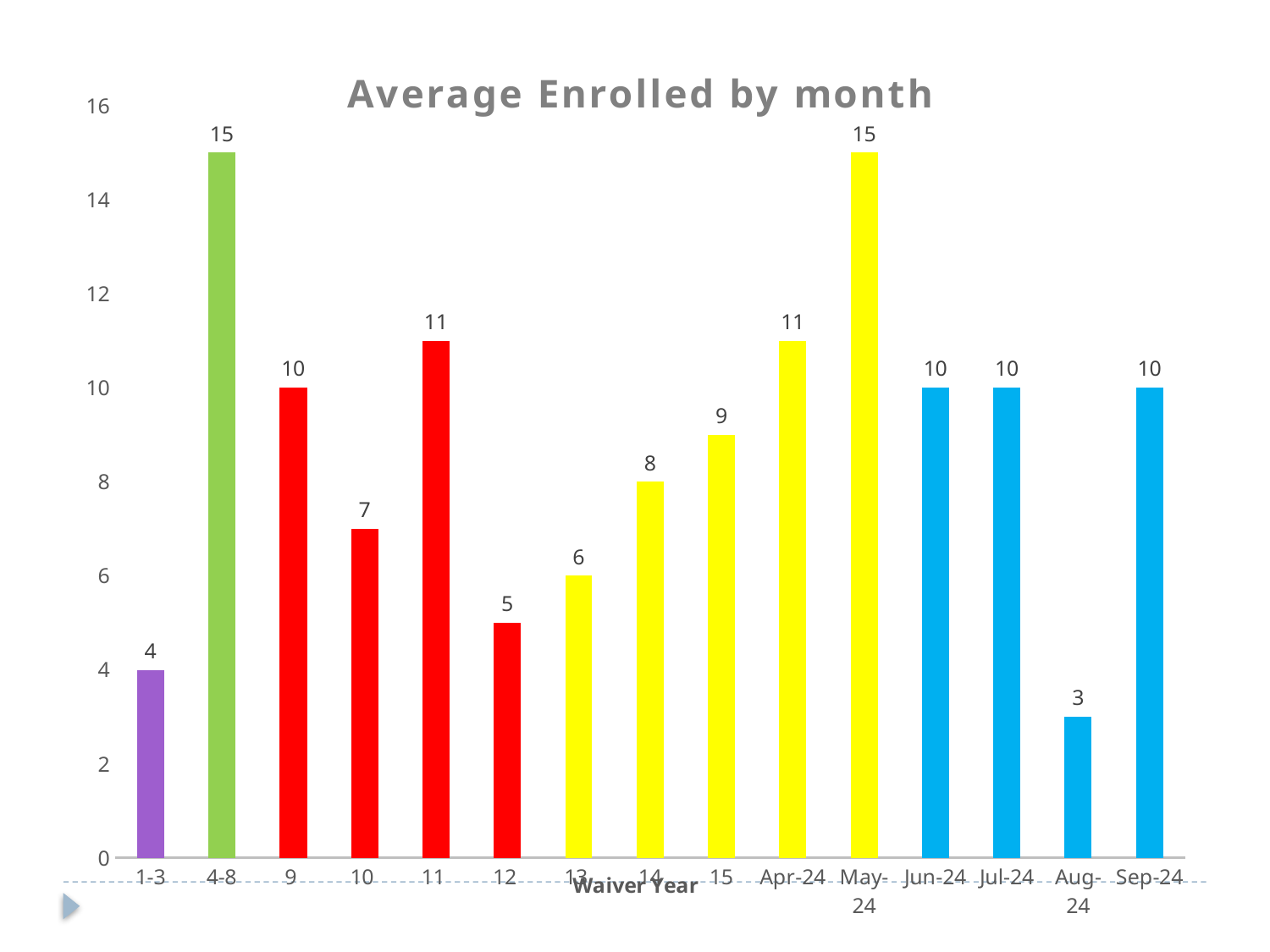
Which category has the lowest value? Aug-24 What is the value for 12? 5 Which is larger, the value for 14 or the value for 13? 14 What is the value for Apr-24? 11 How many categories are shown on the x axis? 15 What is the value for Aug-24? 3 What is the difference between the values for May-24 and Aug-24? 12 What kind of chart is this? bar chart What is the title of the x axis? Waiver Year Is the value for 15 greater or less than 8? greater What is the difference between the values for 11 and 10? 4 What is the value for 4-8? 15